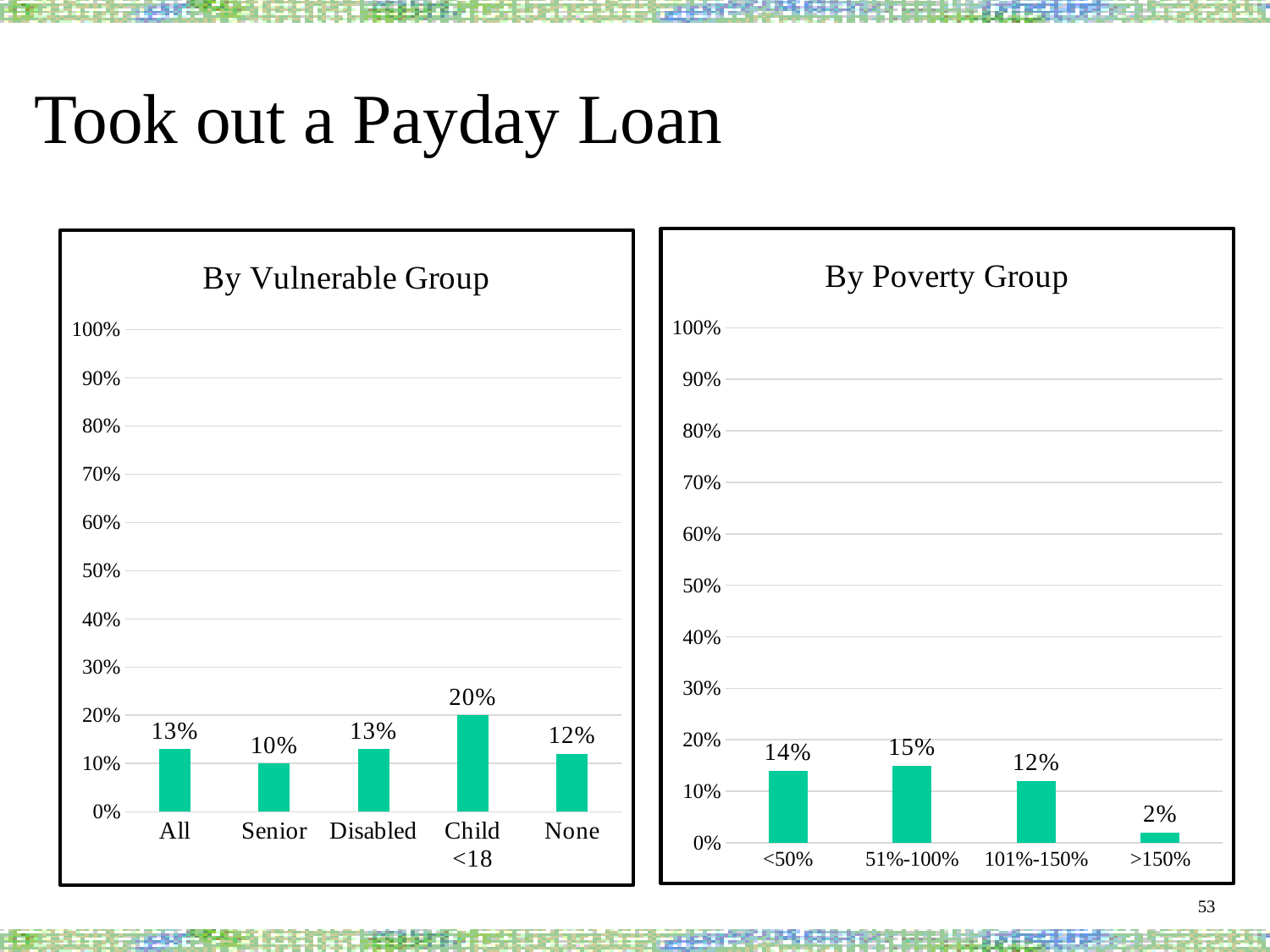
In the 'By Poverty Group' chart, which category has the lowest value? >150% In the 'By Vulnerable Group' chart, how many categories are shown? 5 What kind of chart is the 'By Poverty Group' chart? bar chart In the 'By Vulnerable Group' chart, what is the value for Senior? 10% In the 'By Poverty Group' chart, is the value for <50% larger or smaller than the value for 101%-150%? larger In the 'By Vulnerable Group' chart, what is the difference between the values for Child <18 and None? 8% In the 'By Poverty Group' chart, what is the value for >150%? 2% In the 'By Poverty Group' chart, what is the difference between the values for 51%-100% and >150%? 13% In the 'By Vulnerable Group' chart, which category has the lowest value? Senior In the 'By Vulnerable Group' chart, which category has the highest value? Child <18 In the 'By Vulnerable Group' chart, what is the value for Child <18? 20% In the 'By Poverty Group' chart, what is the value for 51%-100%? 15%